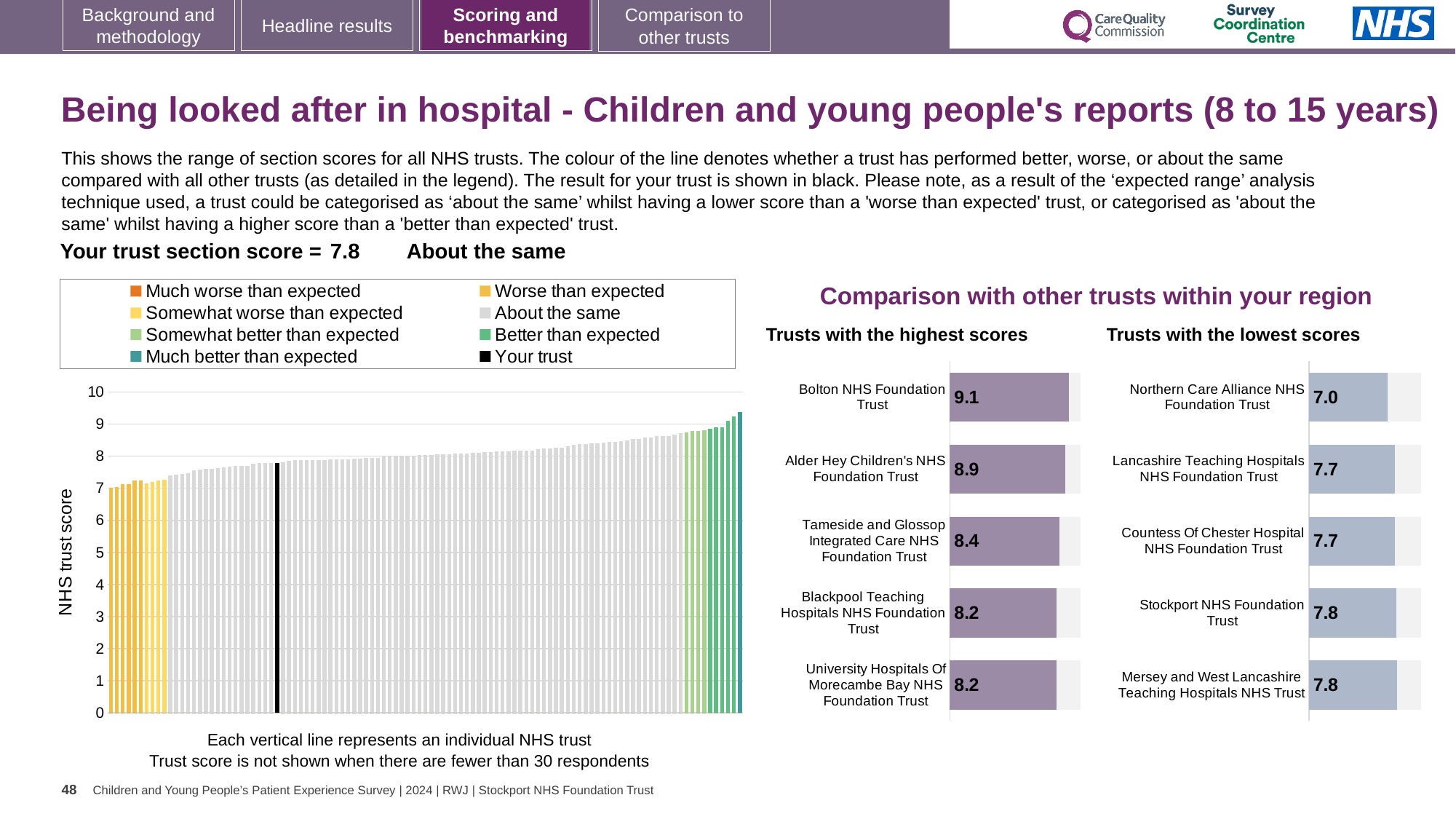
How many trusts are shown in the 'Trusts with the highest scores' chart? 5 In the 'Trusts with the lowest scores' chart, what is the score for Northern Care Alliance NHS Foundation Trust? 7.0 In the 'Trusts with the highest scores' chart, what is the score for Bolton NHS Foundation Trust? 9.1 How many entries does the legend above the large chart on the left list? 8 In the 'Trusts with the highest scores' chart, which has the larger score: Tameside and Glossop Integrated Care NHS Foundation Trust or Blackpool Teaching Hospitals NHS Foundation Trust? Tameside and Glossop Integrated Care NHS Foundation Trust What kind of chart is the large chart on the left showing NHS trust scores? Bar chart In the 'Trusts with the lowest scores' chart, which trust has the lowest score? Northern Care Alliance NHS Foundation Trust In the 'Trusts with the highest scores' chart, what is the difference between the scores of Bolton NHS Foundation Trust and Alder Hey Children's NHS Foundation Trust? 0.2 In the large chart on the left, is the value for the black 'Your trust' bar greater or less than 5? greater In the 'Trusts with the highest scores' chart, which trust has the highest score? Bolton NHS Foundation Trust In the large chart on the left, do the trust scores rise or fall from left to right? Rise In the 'Trusts with the lowest scores' chart, how much higher is Stockport NHS Foundation Trust's score than Northern Care Alliance NHS Foundation Trust's score? 0.8